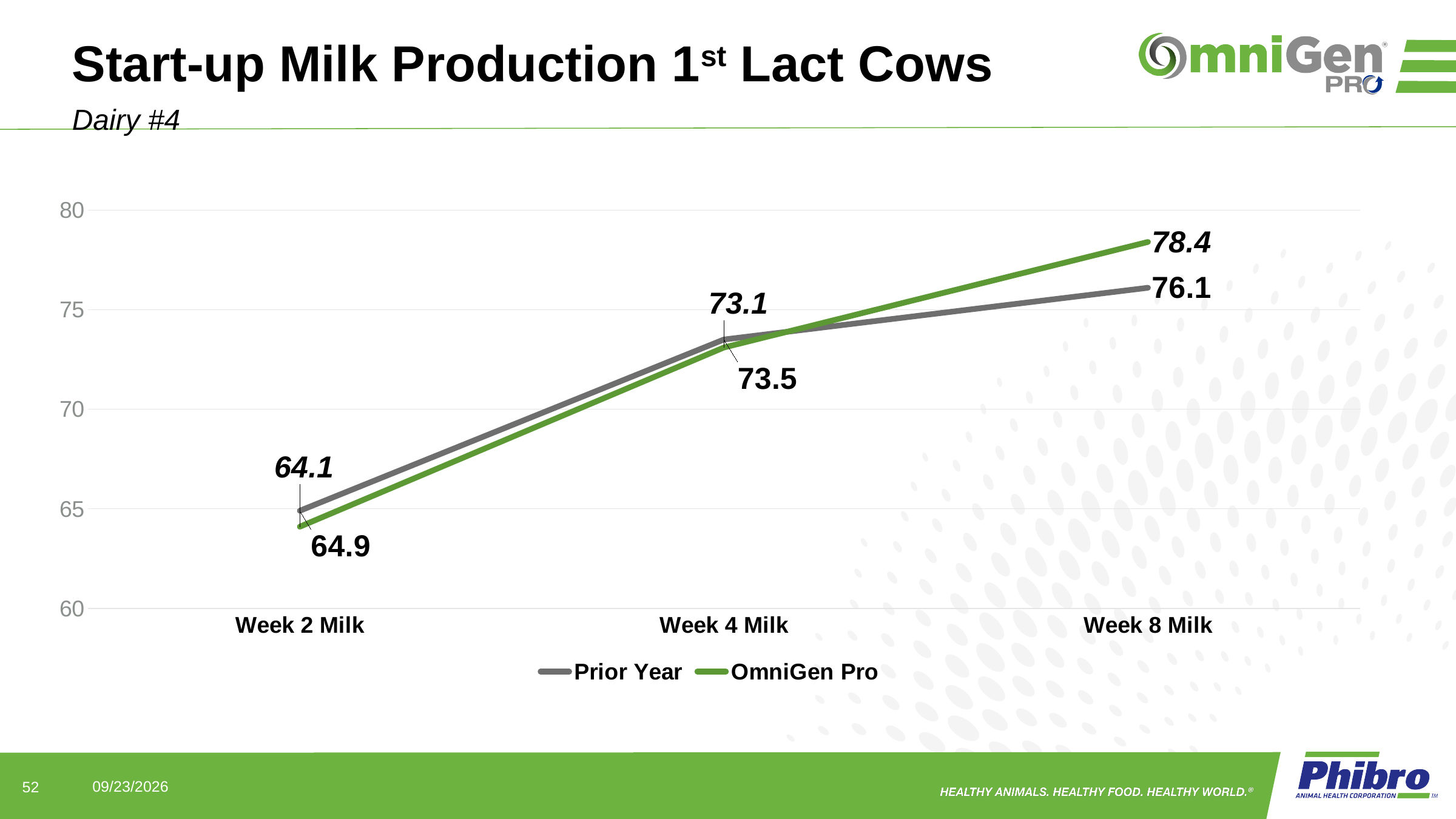
What colour is the OmniGen Pro line? green At Week 8 Milk, which series has the higher value, Prior Year or OmniGen Pro? OmniGen Pro At which category is the Prior Year value lowest? Week 2 Milk How many categories are shown on the x axis? 3 What is the Prior Year value at Week 4 Milk? 73.5 How many series does the legend list? 2 What kind of chart is shown on the slide? line chart Do the OmniGen Pro values rise or fall from Week 2 Milk to Week 8 Milk? rise What is the OmniGen Pro value at Week 8 Milk? 78.4 At which category does the OmniGen Pro series reach its highest value? Week 8 Milk What is the Prior Year value at Week 8 Milk? 76.1 What is the difference between the OmniGen Pro and Prior Year values at Week 8 Milk? 2.3